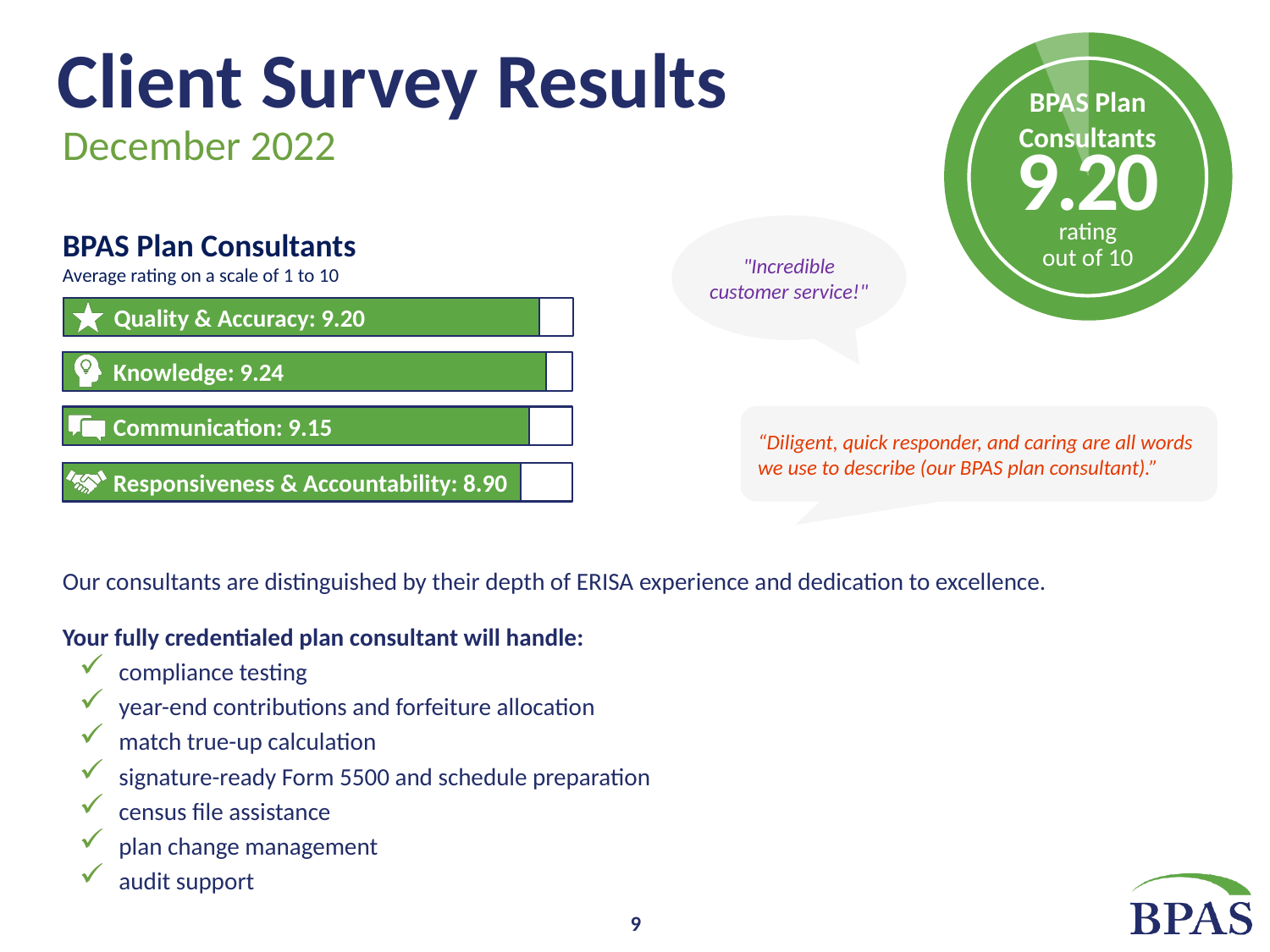
Which category has the lowest average rating? Responsiveness & Accountability What is the average rating for Communication? 9.15 Which is rated higher, Communication or Responsiveness & Accountability? Communication What is the average rating for Knowledge? 9.24 What is the average rating for Quality & Accuracy? 9.20 What is the overall BPAS Plan Consultants rating shown in the green circle? 9.20 What is the difference between the Knowledge rating and the Responsiveness & Accountability rating? 0.34 How many categories are shown in the bar chart? 4 What is the average rating for Responsiveness & Accountability? 8.90 What is the difference between the Quality & Accuracy rating and the Communication rating? 0.05 What kind of chart is used to show the BPAS Plan Consultants ratings? Bar chart Which category has the highest average rating? Knowledge